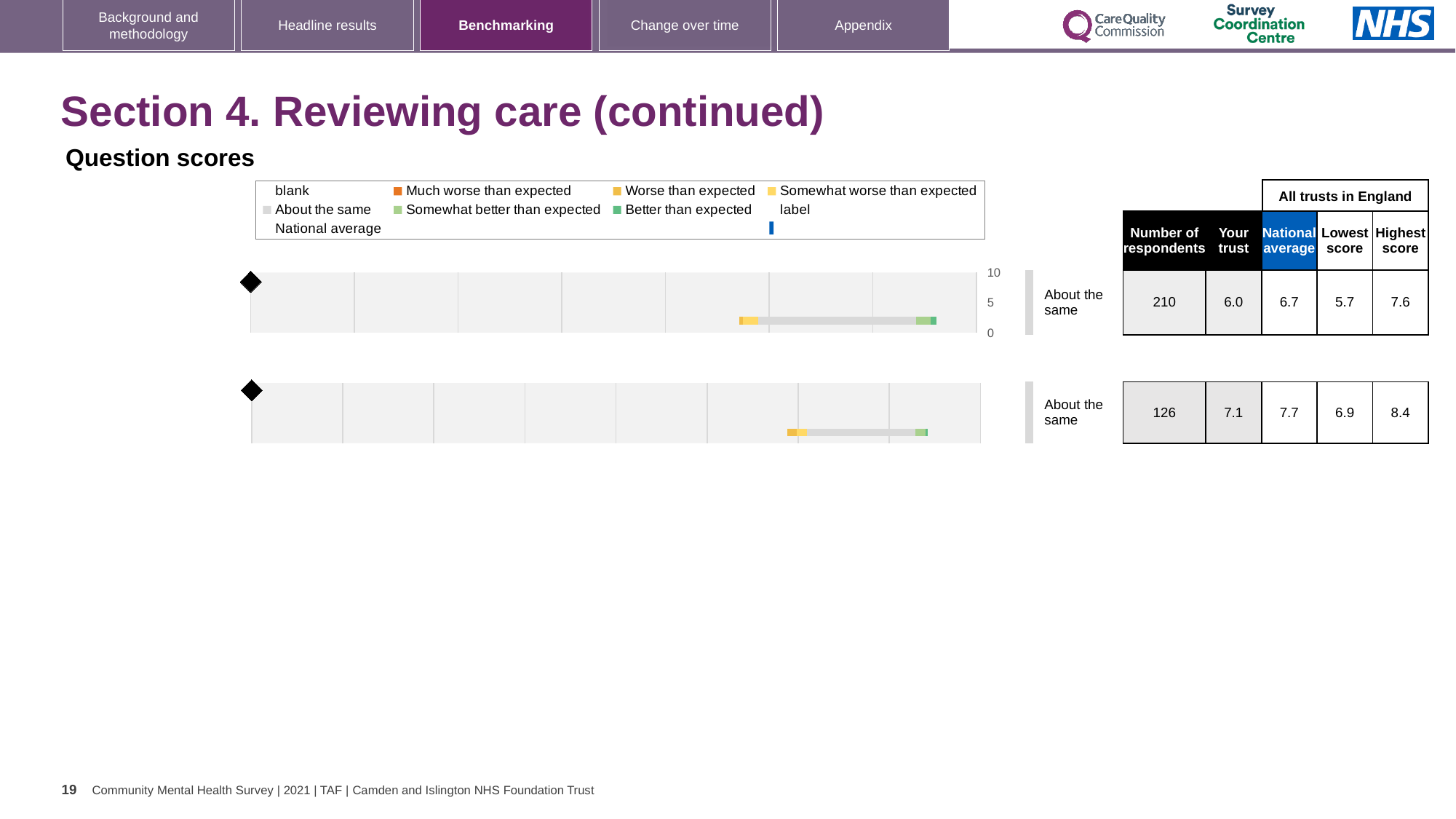
Which chart, top or bottom, has the higher score for Your trust? bottom On the top chart, what is the National average score? 6.7 On the bottom chart, what is the difference between the Highest score and the Lowest score? 1.5 What kind of chart is used to show the question scores on this slide? bar chart On the top chart, is the Your trust score greater or less than 5? greater On the bottom chart, what is the score for Your trust? 7.1 On the top chart, how many respondents are there? 210 On the bottom chart, what is the National average score? 7.7 On the top chart, what is the score for Your trust? 6.0 On the top chart, what is the Lowest score among all trusts in England? 5.7 On the top chart, what is the difference between the National average and the Your trust score? 0.7 On the bottom chart, what is the Highest score among all trusts in England? 8.4